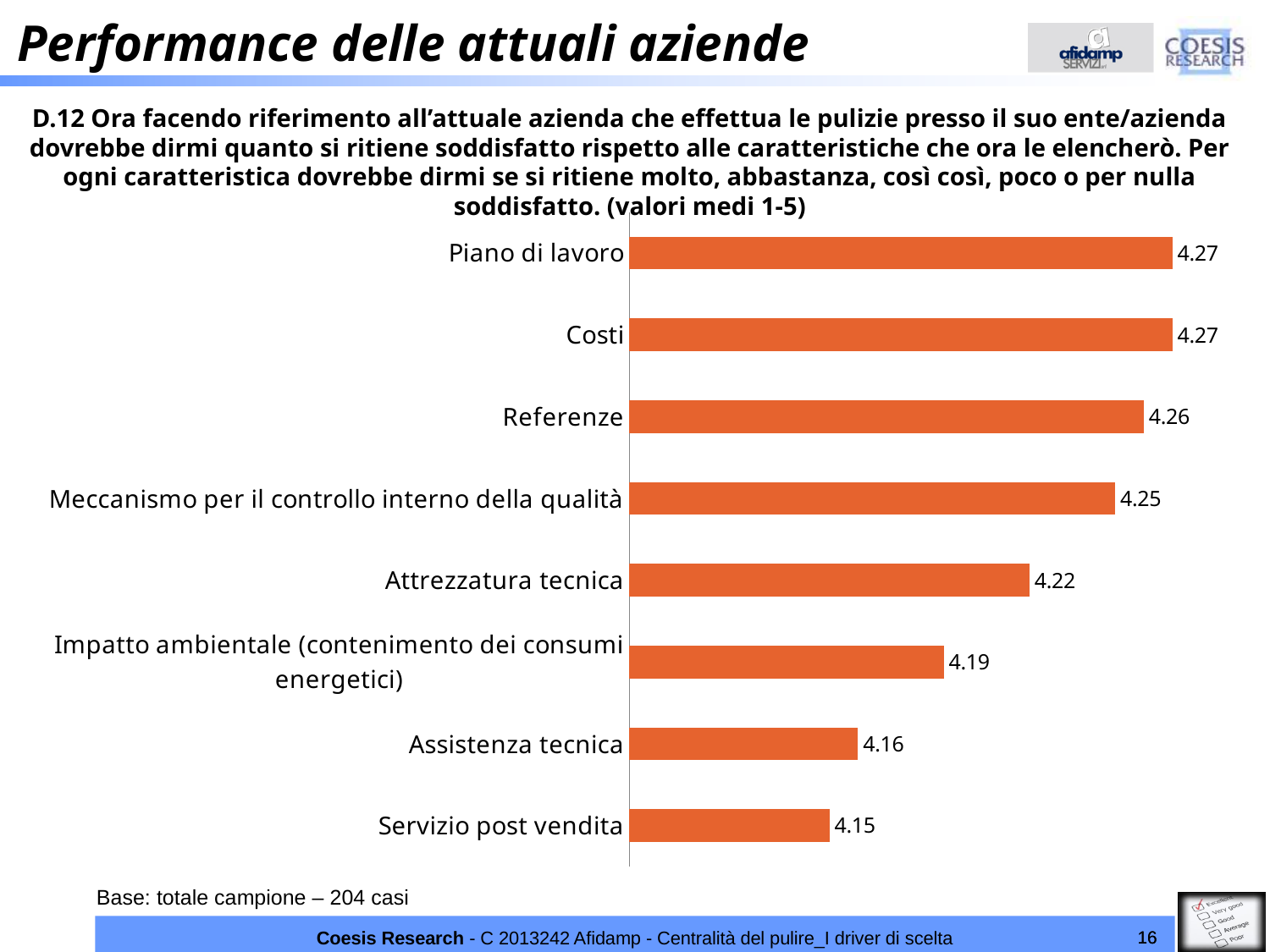
What is the value for Meccanismo per il controllo interno della qualità? 4.25 What kind of chart is shown on the slide? Bar chart How many categories are shown in the chart? 8 What is the value for Referenze? 4.26 What is the difference between the values for Piano di lavoro and Servizio post vendita? 0.12 Which has a higher value, Attrezzatura tecnica or Servizio post vendita? Attrezzatura tecnica What is the value for Servizio post vendita? 4.15 What is the value for Impatto ambientale (contenimento dei consumi energetici)? 4.19 Which category has the lowest value? Servizio post vendita What is the value for Piano di lavoro? 4.27 What is the difference between the values for Attrezzatura tecnica and Assistenza tecnica? 0.06 What is the base (sample size) stated below the chart? 204 casi